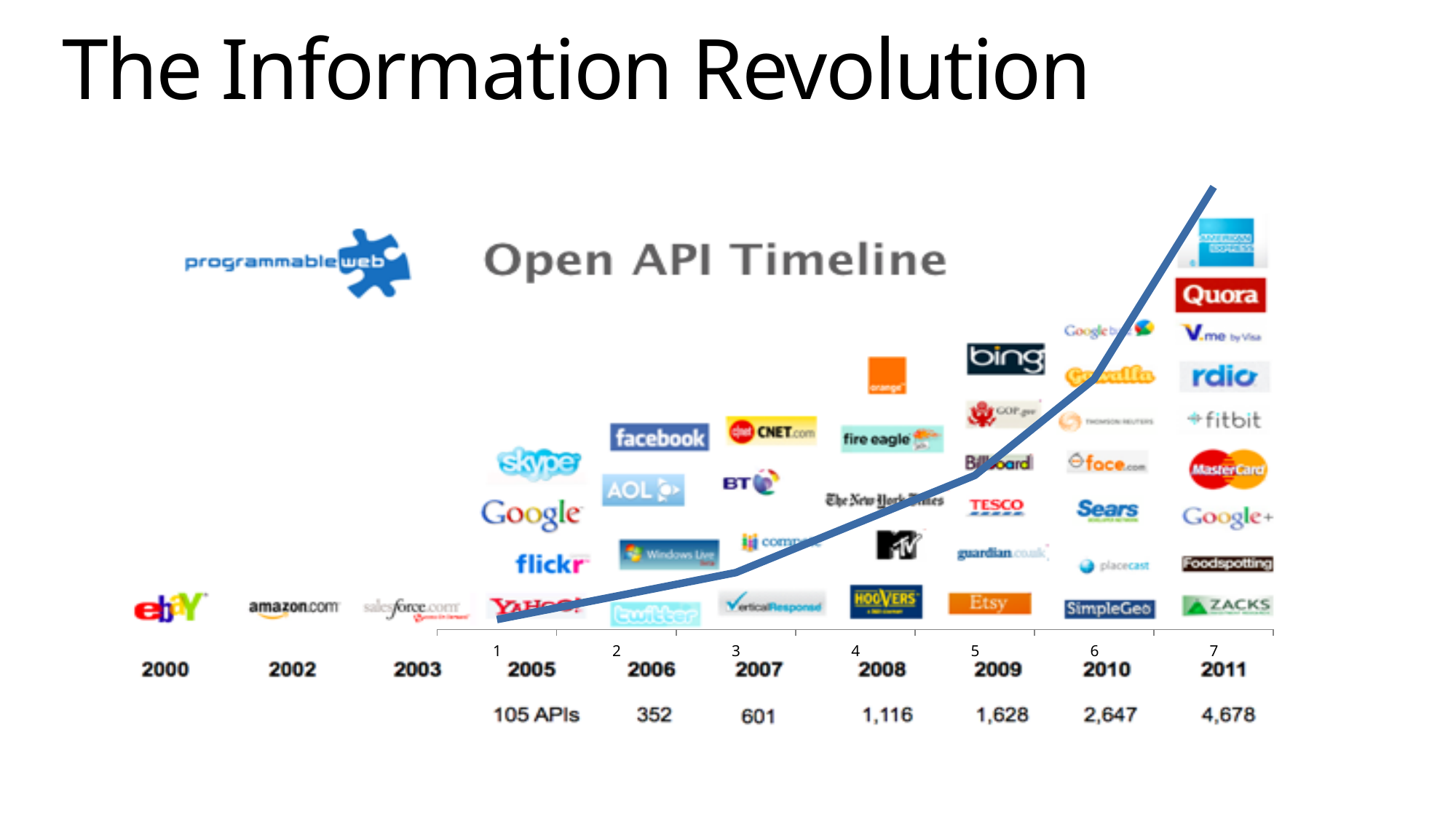
What kind of chart is overlaid on the Open API Timeline image? line chart What is the number of APIs printed for 2005? 105 APIs Which year has more APIs, 2007 or 2009? 2009 Which year has the lowest number of APIs among those with a printed count? 2005 What is the number of APIs printed for 2008? 1,116 What is the number of APIs printed for 2011? 4,678 What is the title shown in the timeline image? Open API Timeline What is the difference between the API counts for 2011 and 2010? 2,031 Which year has the highest number of APIs? 2011 What is the difference between the API counts for 2006 and 2005? 247 Does the line rise or fall from 2005 to 2011? rises How many API count values are printed along the timeline from 2005 to 2011? 7